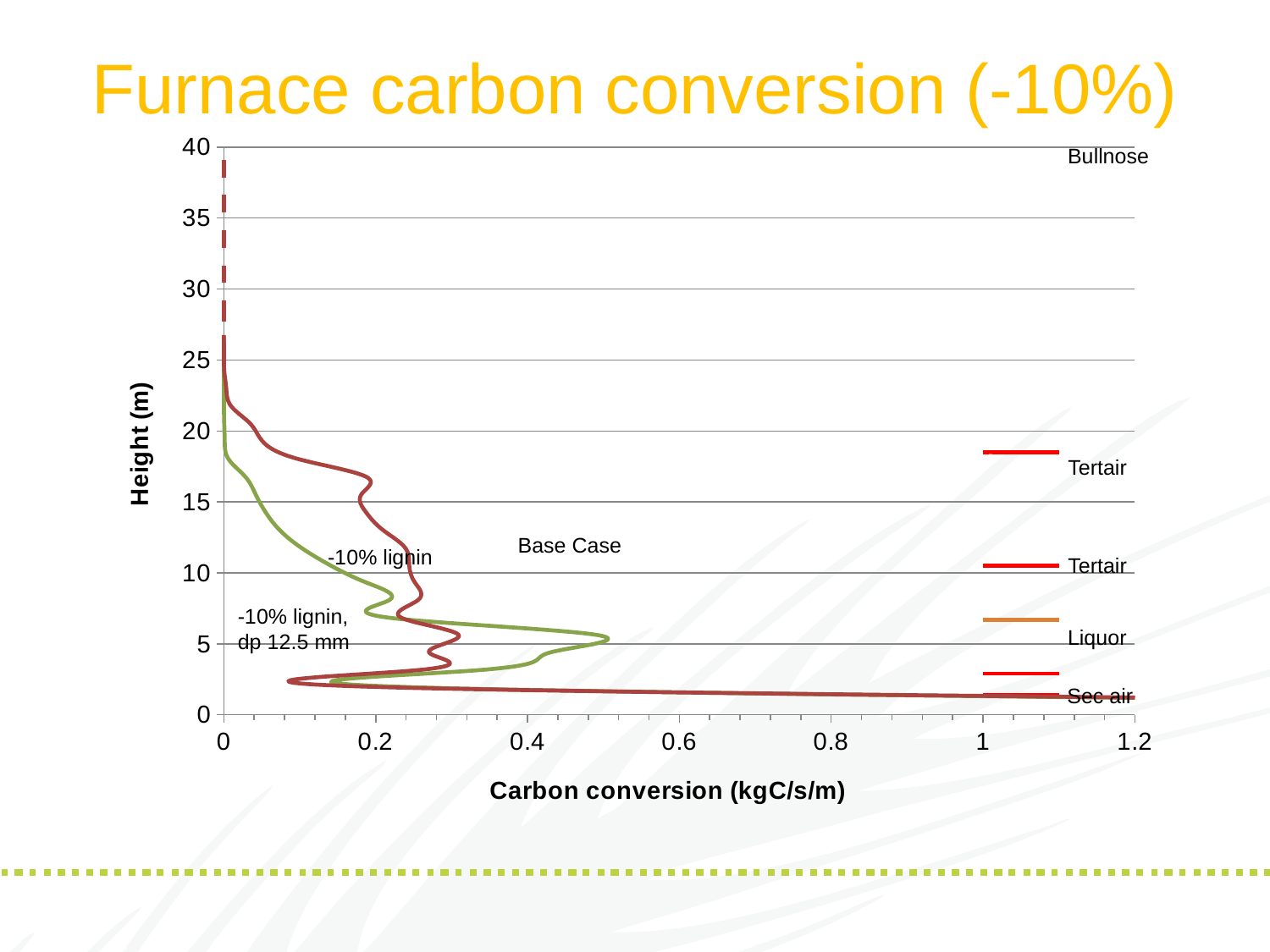
Is the peak carbon conversion of the -10% lignin curve, near a height of 5 m, greater or less than 0.4? greater At a height of 10 m, is the carbon conversion of the -10% lignin curve greater or less than 0.4? less At a height of 20 m, is the carbon conversion of the Base Case curve greater or less than 0.2? less What is the highest value shown on the x axis of the chart? 1.2 What is the title of the x axis of the chart? Carbon conversion (kgC/s/m) Which annotation label appears at the top of the chart, near a height of 40 m? Bullnose At a height of 15 m, which curve has the larger carbon conversion, Base Case or -10% lignin? Base Case What kind of chart is shown on the slide? line chart Going up the furnace from a height of 5 m to 25 m, does the carbon conversion of the -10% lignin curve generally rise or fall? fall At a height of 5 m, which curve has the larger carbon conversion, Base Case or -10% lignin? -10% lignin What is the highest value shown on the y axis (Height) of the chart? 40